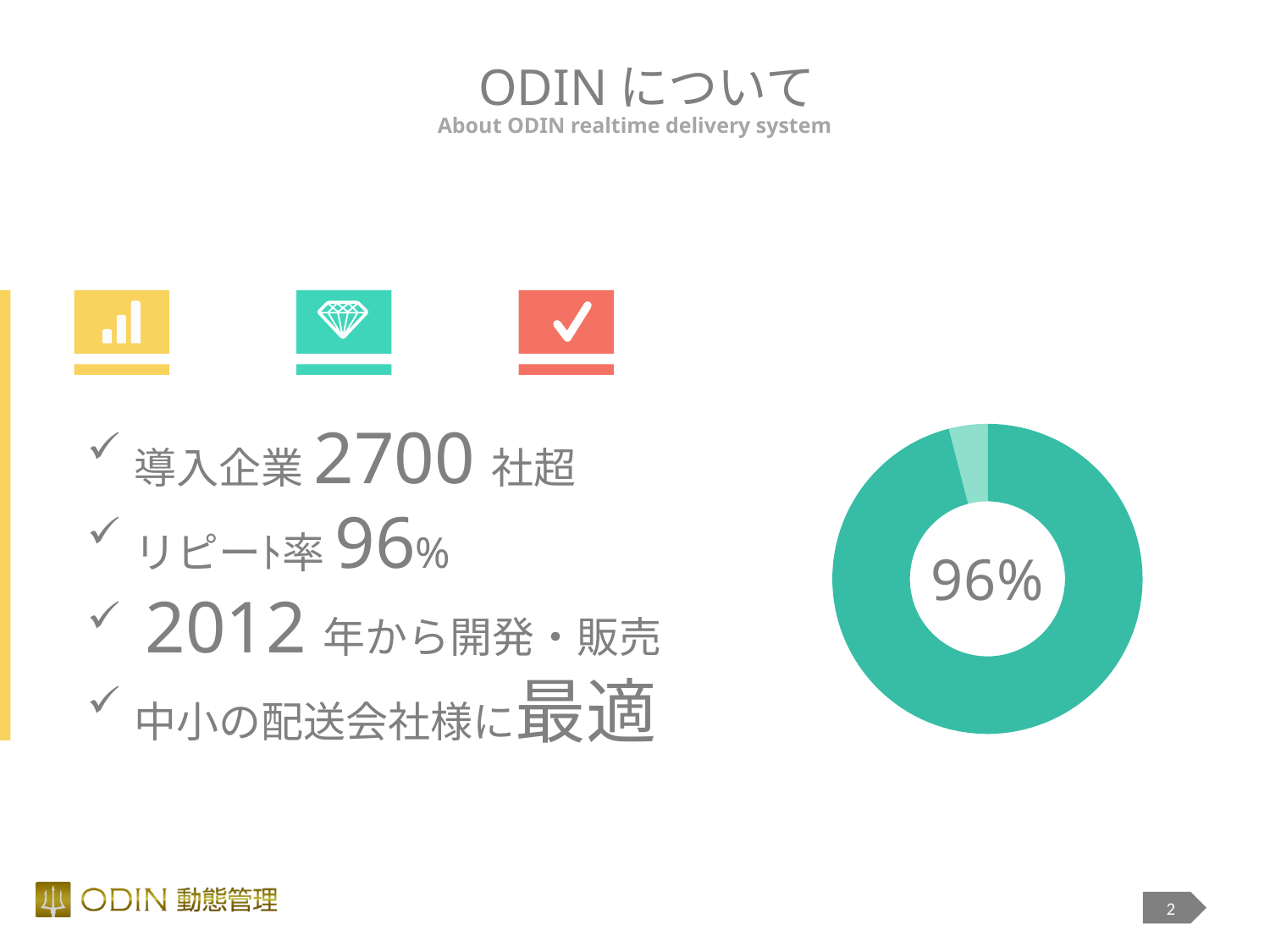
According to the slide text, what metric does the 96% in the donut chart represent? リピート率 (repeat rate) Is the share shown by the large slice of the donut chart greater or less than 90%? greater What share of the donut chart does the small light teal slice represent? 4% Is the share of the small slice of the donut chart greater or less than 10%? less How many slices does the donut chart have? 2 What kind of chart is shown on the slide? Donut (pie) chart What share of the donut chart does the large dark teal slice represent? 96% What colour is the large slice of the donut chart? Teal (green) Which slice of the donut chart is larger, the dark teal slice or the light teal slice? The dark teal slice What value is printed in the center of the donut chart? 96%